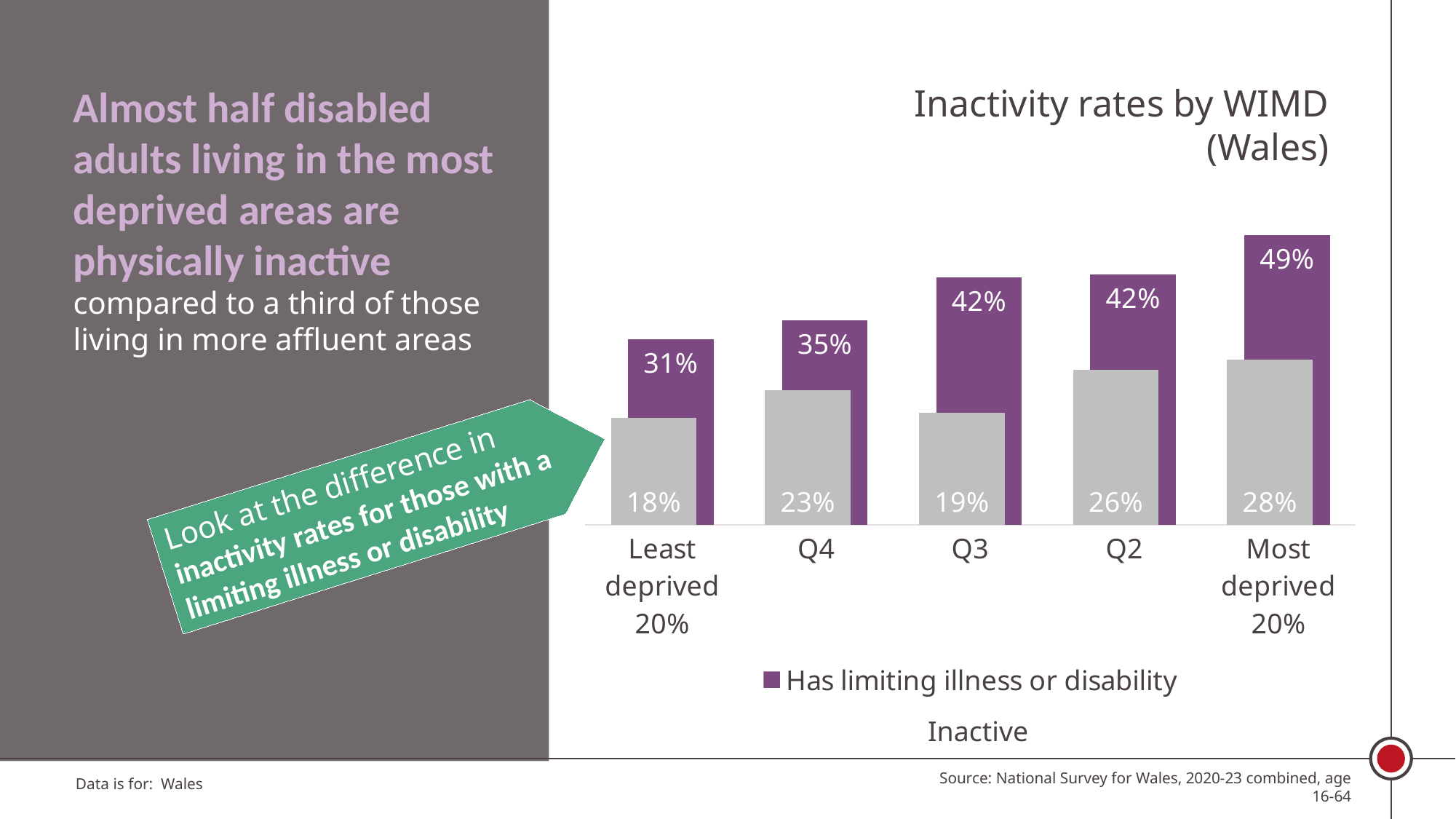
What is the difference between the 'Has limiting illness or disability' value and the Inactive value for Q3? 23 percentage points Which category has the lowest value for the Inactive series? Least deprived 20% What is the inactivity rate for those with a limiting illness or disability in the Most deprived 20% group? 49% What is the value of the Inactive series for Q4? 23% What is the title of the chart? Inactivity rates by WIMD (Wales) What is the value for 'Has limiting illness or disability' in the Least deprived 20% group? 31% Which category has the highest value for the 'Has limiting illness or disability' series? Most deprived 20% How many series does the legend list? 2 Which is larger for Q2: the 'Has limiting illness or disability' value or the Inactive value? Has limiting illness or disability How many deprivation categories are shown on the x axis? 5 Do the values for 'Has limiting illness or disability' rise or fall from Least deprived 20% to Most deprived 20%? Rise What kind of chart is shown on the slide? Bar chart